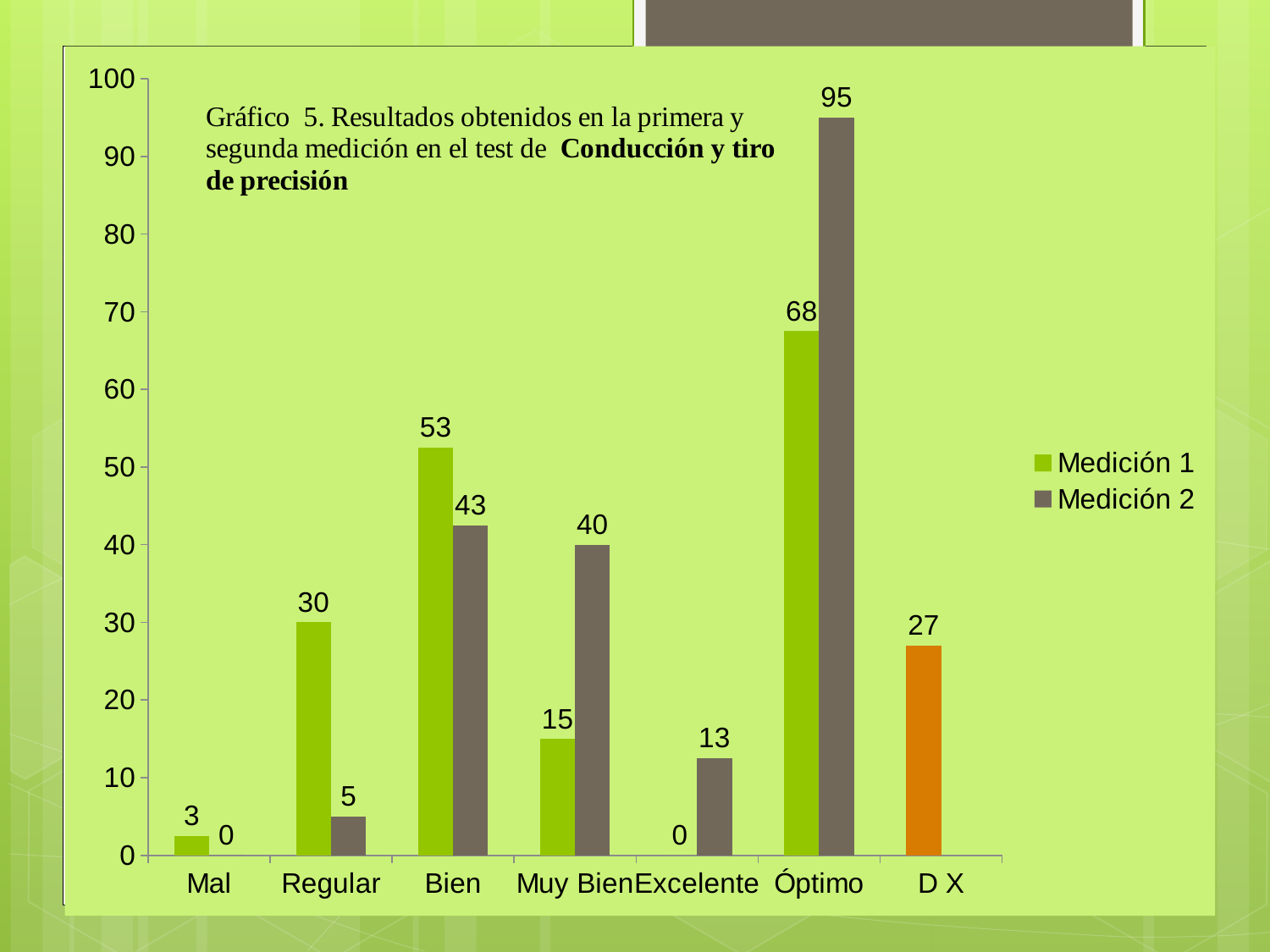
Which category has the lowest value for Medición 1 among those with a Medición 1 bar? Mal Which category has the highest value for Medición 2? Óptimo What kind of chart is shown on the slide? bar chart How many series does the legend list? 2 What is the difference between Medición 2 and Medición 1 for Óptimo? 27 Which is larger for Regular: Medición 1 or Medición 2? Medición 1 What is the value of Medición 2 for Muy Bien? 40 How many categories are shown on the x axis? 7 What is the value of Medición 1 for Bien? 53 What is the value of Medición 1 for Excelente? 0 Is the value of Medición 2 for Bien greater or less than 50? less What is the value of Medición 2 for Óptimo? 95